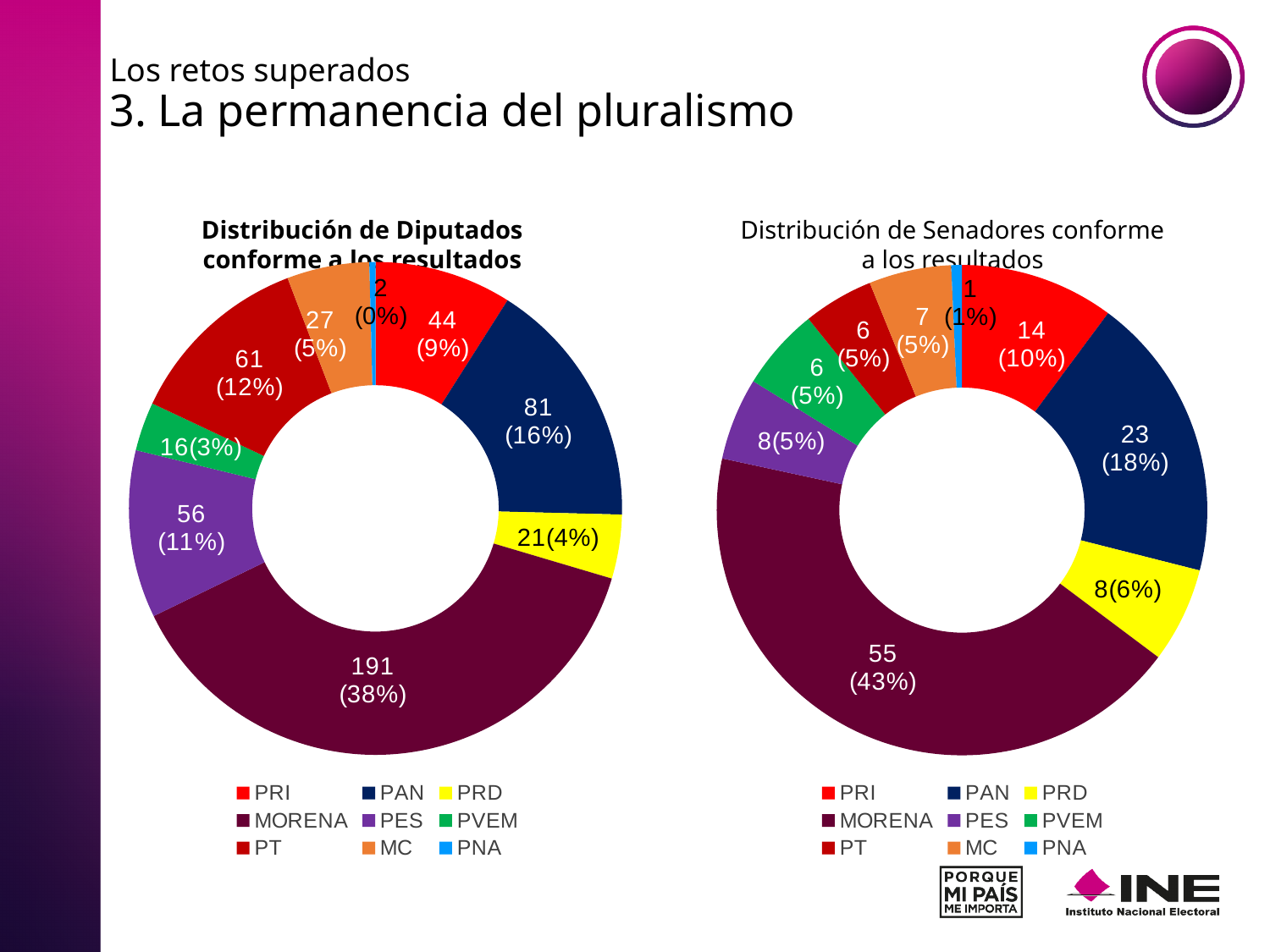
In the Distribución de Diputados chart, which colour represents MORENA? Dark maroon In the Distribución de Senadores chart, what is the difference between the MORENA value and the PAN value? 32 In the Distribución de Diputados chart, how many diputados does MORENA have? 191 How many parties does the legend of the Distribución de Senadores chart list? 9 In the Distribución de Diputados chart, which party has the smallest slice? PNA What kind of chart is the Distribución de Diputados chart? Doughnut (pie) chart In the Distribución de Diputados chart, what is the difference between the PT value and the PES value? 5 In the Distribución de Diputados chart, what share of the total does PAN hold? 16% In the Distribución de Senadores chart, which is larger, the PRI value or the PRD value? PRI In the Distribución de Senadores chart, what share of the total does MORENA hold? 43% In the Distribución de Senadores chart, how many senadores does PAN have? 23 In the Distribución de Diputados chart, which party has the largest slice? MORENA